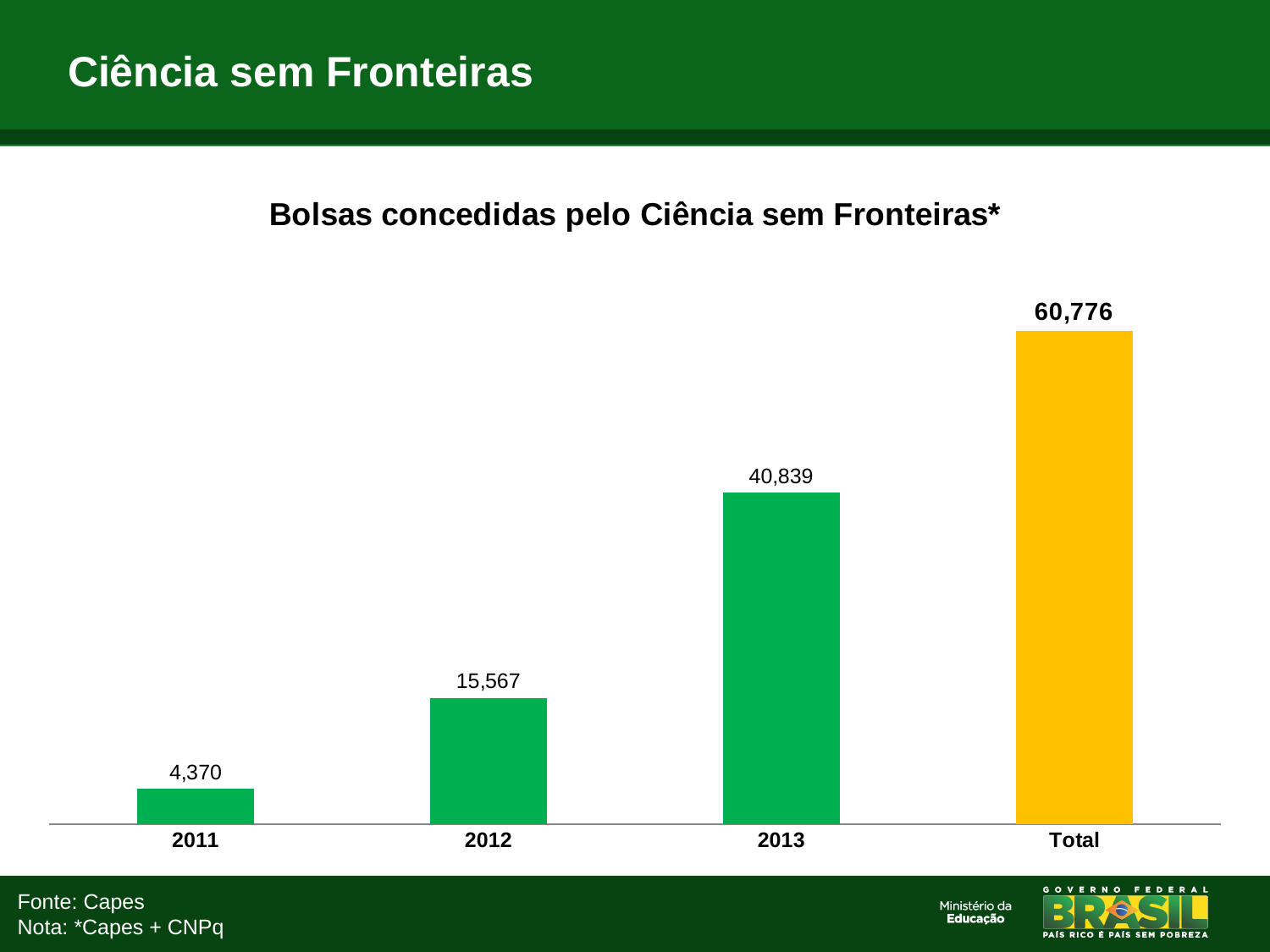
What kind of chart is shown on the slide? Bar chart Do the values rise or fall from 2011 to 2013? Rise What is the value for 2011? 4,370 Which category has the lowest value? 2011 What is the difference between the values for 2013 and 2012? 25,272 What is the value for 2013? 40,839 Which is larger, the value for 2012 or the value for 2013? 2013 What is the value for 2012? 15,567 What is the difference between the values for 2012 and 2011? 11,197 How many bars are shown in the chart? 4 Which year (excluding Total) has the highest value? 2013 What is the value for Total? 60,776